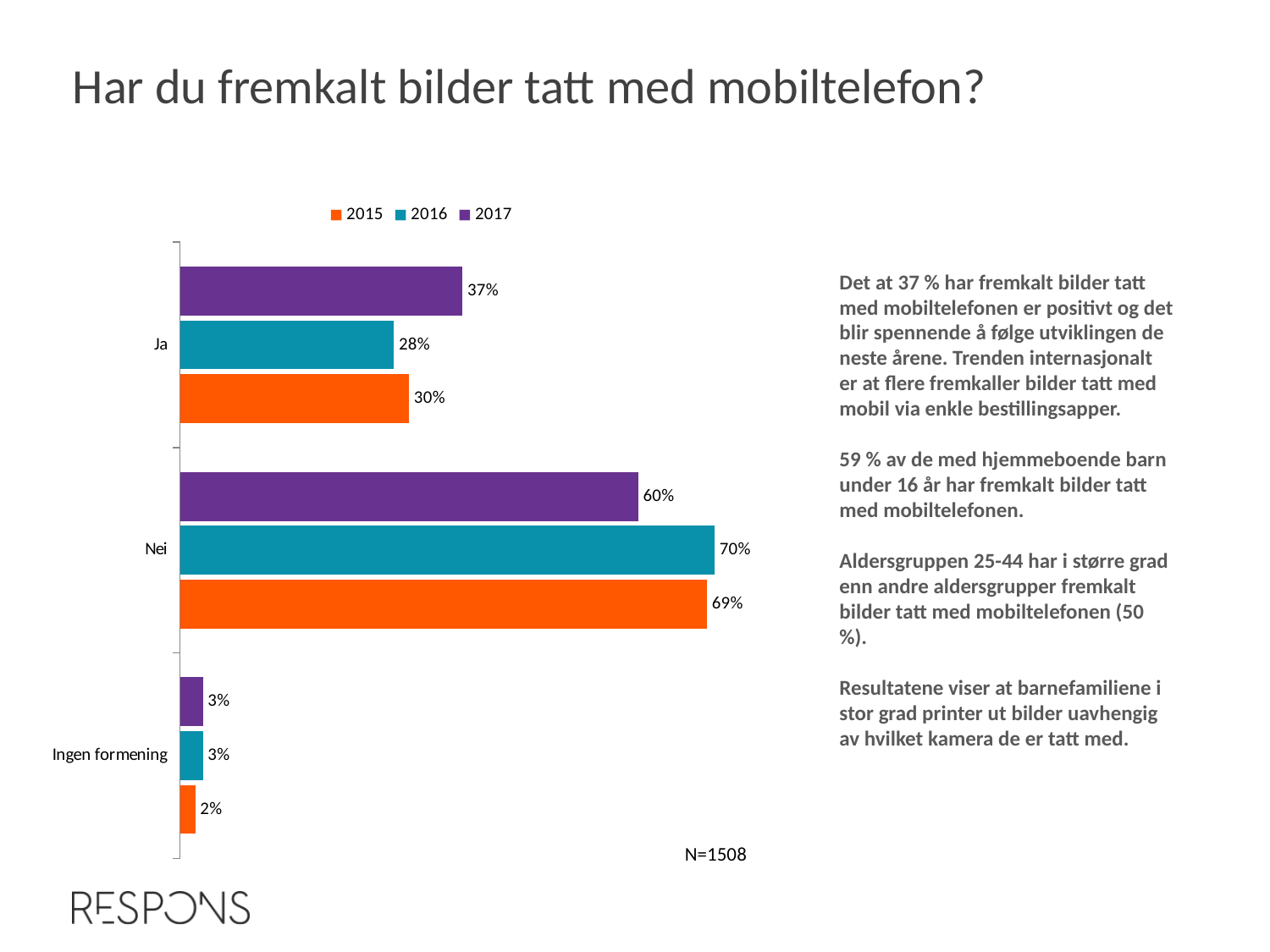
Which series is shown in orange in the legend? 2015 What is the value for "Ja" in the 2015 series? 30% How many series does the legend list? 3 How many categories are shown on the chart? 3 Which is larger for "Ja": the 2015 value or the 2016 value? 2015 Which category has the highest value in the 2017 series? Nei What is the value for "Ingen formening" in the 2015 series? 2% What is the value for "Nei" in the 2016 series? 70% Which category has the lowest value in the 2016 series? Ingen formening What kind of chart is shown on the slide? Bar chart What is the difference between the 2016 and 2017 values for "Nei"? 10% What is the value for "Ja" in the 2017 series? 37%